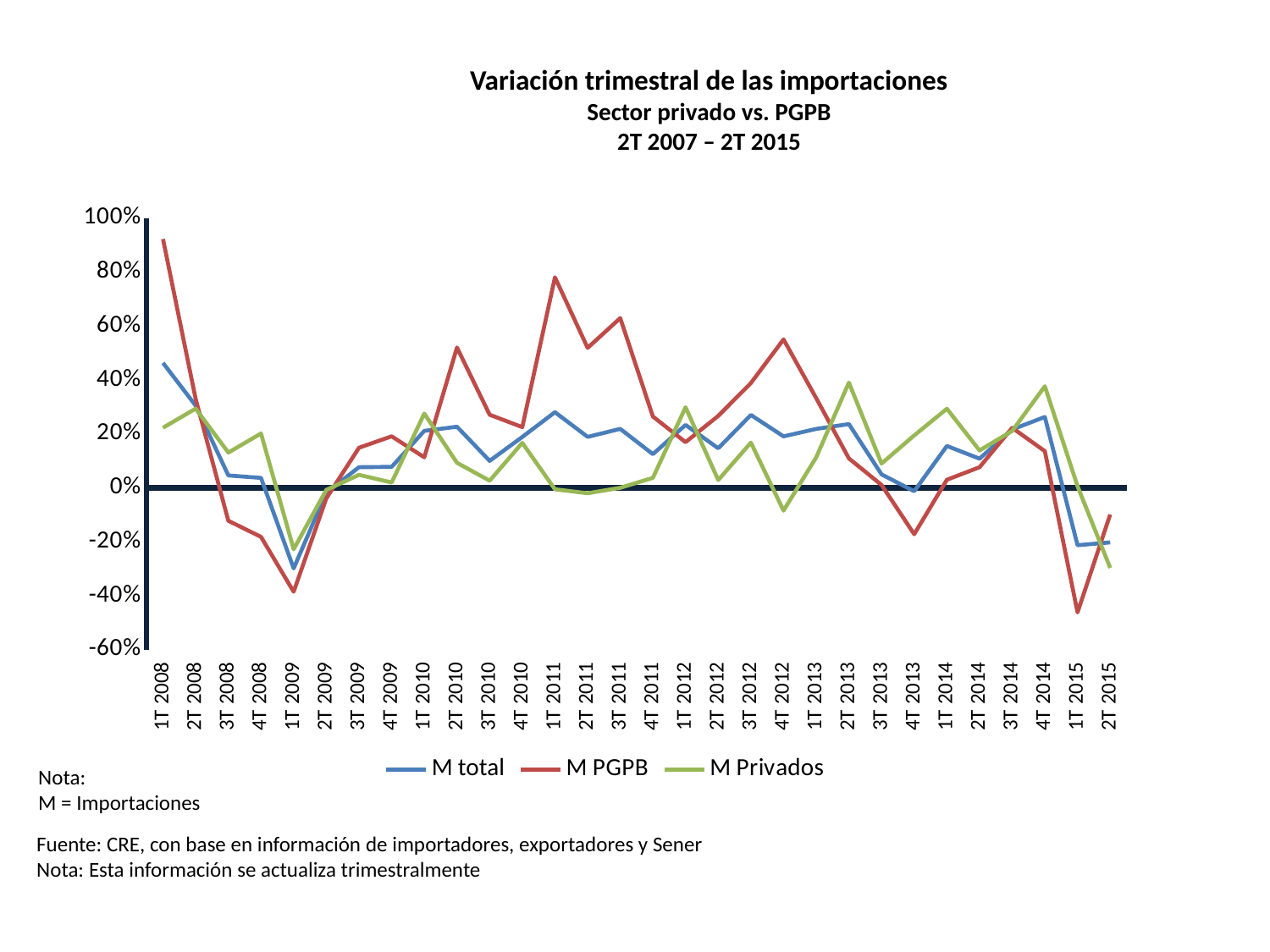
Is the value for M Privados in 4T 2012 greater or less than 0%? less Is the value for M PGPB in 1T 2015 greater or less than -40%? less In which quarter does the M PGPB series reach its highest value? 1T 2008 Is the value for M PGPB in 1T 2011 greater or less than 60%? greater In 1T 2011, which series has the larger value, M PGPB or M Privados? M PGPB How many quarters are plotted along the x axis? 30 In which quarter does the M PGPB series reach its lowest value? 1T 2015 What kind of chart is shown on the slide? Line chart How many series does the legend list? 3 Does the M PGPB series rise or fall from 1T 2008 to 1T 2009? Fall In which quarter does the M total series reach its highest value? 1T 2008 In which quarter does the M Privados series reach its lowest value? 2T 2015